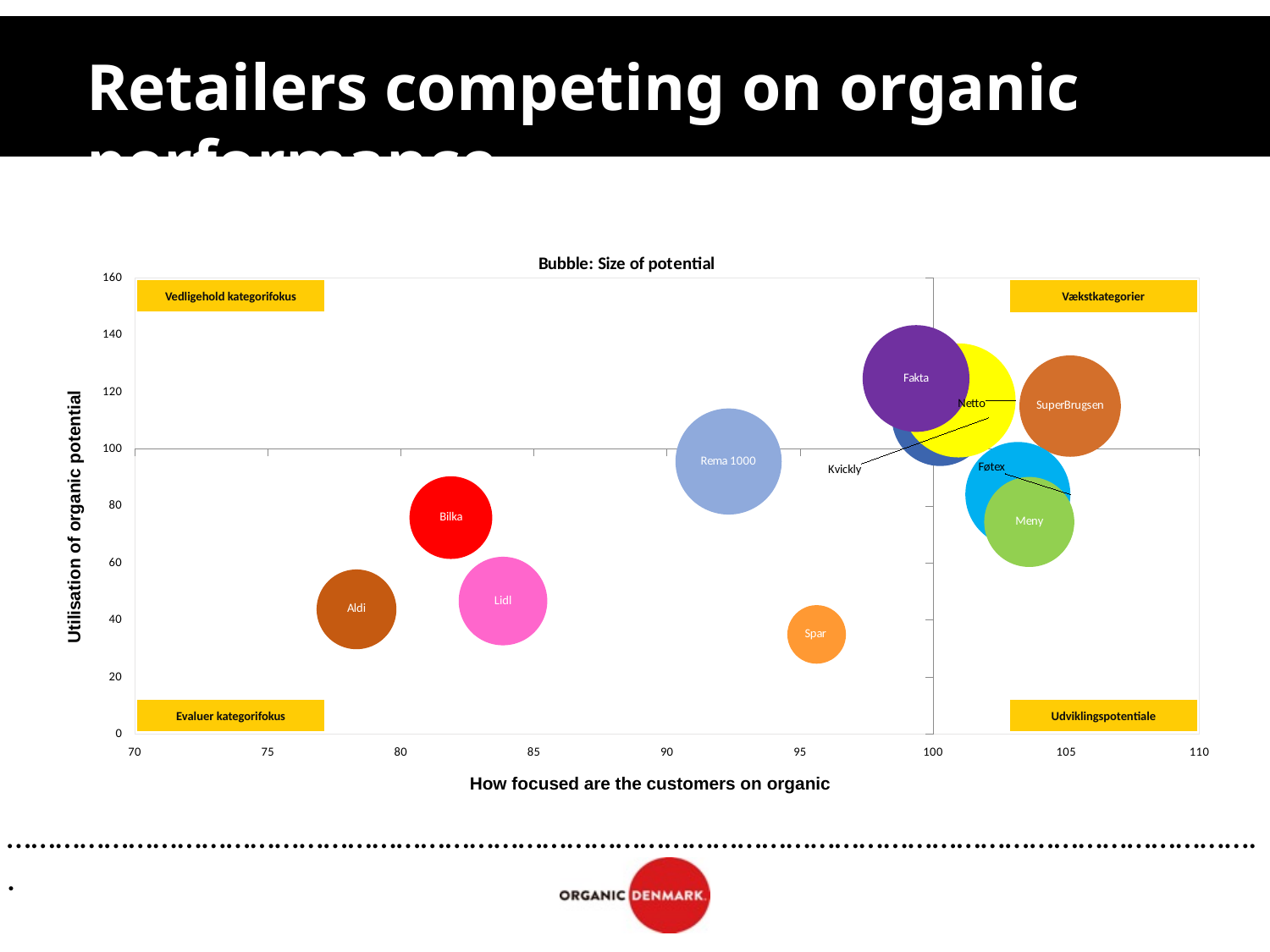
Which retailer has the lowest utilisation of organic potential? Spar What kind of chart is shown on the slide? Bubble chart How many retailers are plotted as bubbles on the chart? 11 Is the utilisation of organic potential for Aldi greater or less than 60? less Is the value for Rema 1000 on the 'How focused are the customers on organic' axis greater or less than 95? less Is the value for SuperBrugsen on the 'How focused are the customers on organic' axis greater or less than 100? greater What is the label on the vertical axis of the chart? Utilisation of organic potential Which retailer has a higher utilisation of organic potential, Bilka or Lidl? Bilka What is the title of the chart? Bubble: Size of potential Which retailer has the lowest value on the 'How focused are the customers on organic' axis? Aldi Which retailer has the highest utilisation of organic potential? Fakta